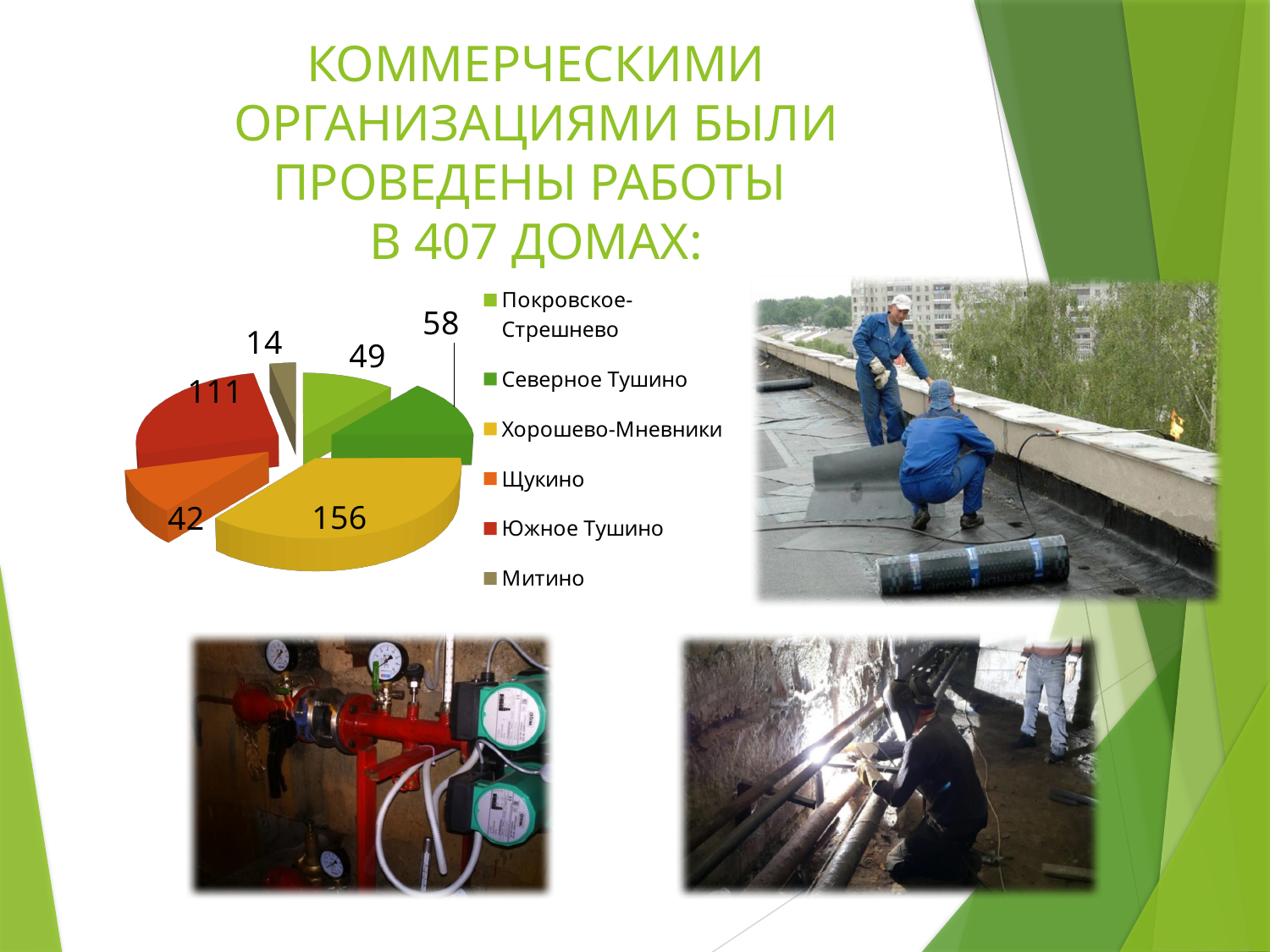
What colour is the slice for Южное Тушино in the pie chart? Red Which category has the smallest slice in the pie chart? Митино How many entries does the legend of the pie chart list? 6 What is the value for Южное Тушино in the pie chart? 111 What is the value for Хорошево-Мневники in the pie chart? 156 How many slices does the pie chart have? 6 What is the difference between the values for Хорошево-Мневники and Южное Тушино? 45 What is the value for Щукино in the pie chart? 42 Which is larger in the pie chart, Северное Тушино or Покровское-Стрешнево? Северное Тушино What is the value for Митино in the pie chart? 14 Which category has the largest slice in the pie chart? Хорошево-Мневники What kind of chart is shown on the slide? Pie chart